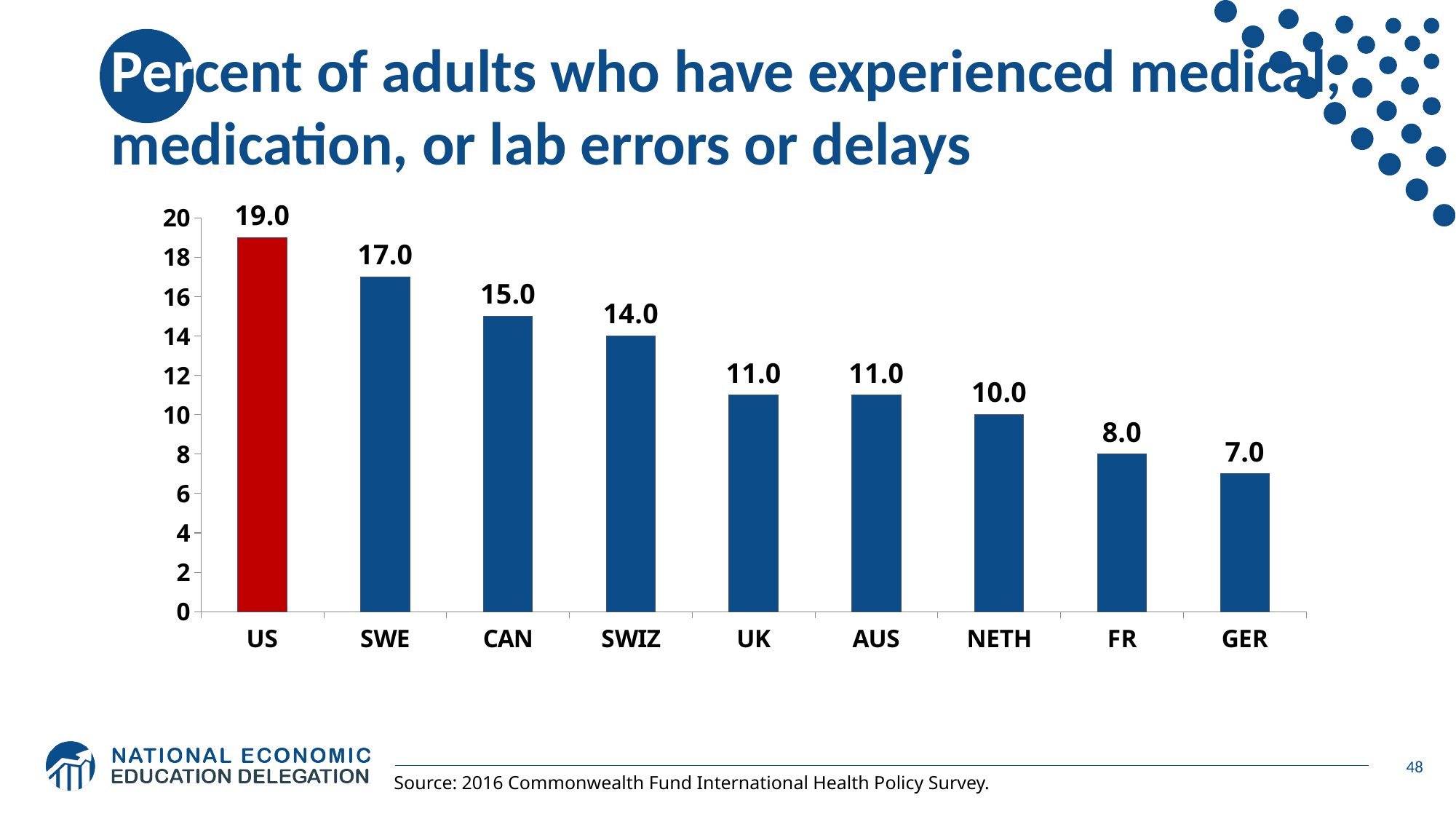
Which bar is coloured red rather than blue? US Which is larger, the value for FR or the value for NETH? NETH What is the value for SWIZ? 14.0 How many countries are shown on the x axis? 9 Is the value for CAN greater or less than 10? greater What is the value for the US? 19.0 What is the value for NETH? 10.0 What is the difference between the values for CAN and GER? 8.0 What is the difference between the values for the US and SWE? 2.0 What kind of chart is shown on the slide? bar chart Which country has the lowest value? GER Which country has the highest value? US